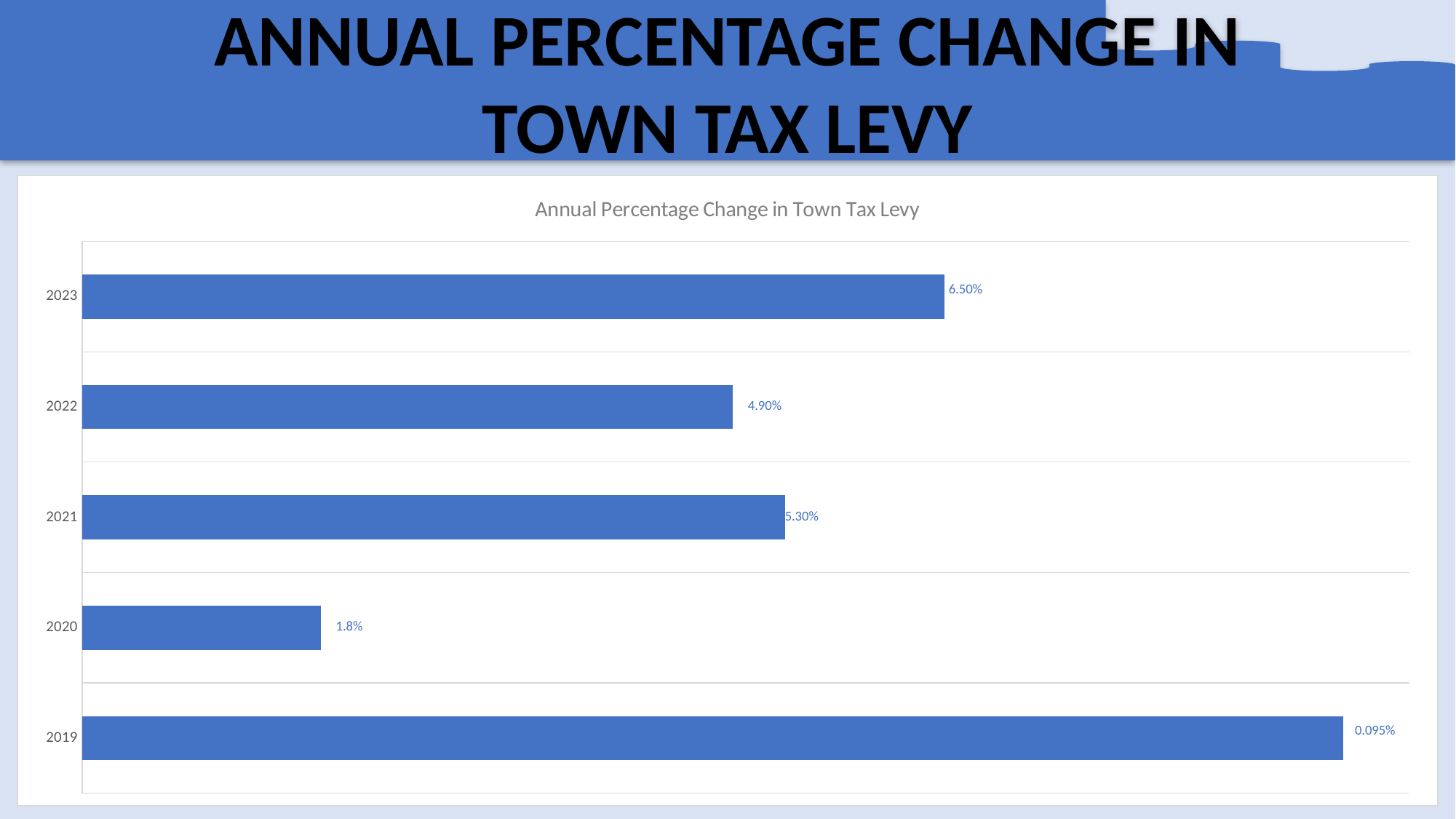
What is the difference between the values for 2023 and 2022? 1.60% What is the value shown for 2021? 5.30% Which year has the larger value, 2023 or 2022? 2023 What is the value shown for 2023? 6.50% What is the difference between the values for 2021 and 2022? 0.40% What is the value shown for 2020? 1.8% What is the title of the chart? Annual Percentage Change in Town Tax Levy What data label is shown for 2019? 0.095% How many years are shown in the chart? 5 What is the value shown for 2022? 4.90% What kind of chart is shown on the slide? Bar chart Which year has the larger value, 2021 or 2022? 2021